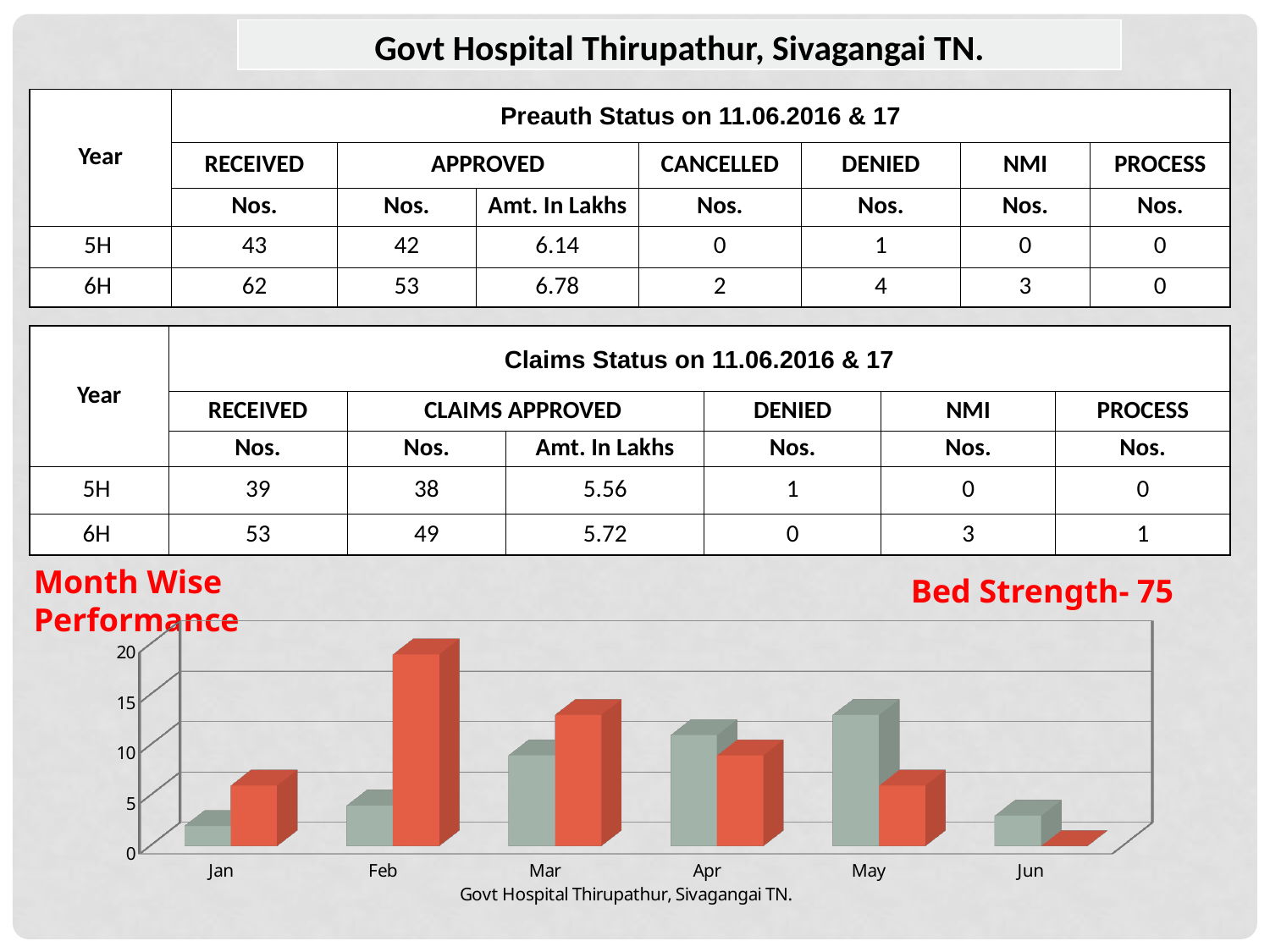
In the Month Wise Performance chart, is the red bar for Feb greater or less than 15? greater What text appears below the x axis of the Month Wise Performance chart? Govt Hospital Thirupathur, Sivagangai TN. In the Month Wise Performance chart, is the red bar for Jun greater or less than 5? less How many series of bars are plotted for each month in the Month Wise Performance chart? 2 In the Month Wise Performance chart, which bar is taller for Feb, the grey bar or the red bar? the red bar What kind of chart is shown under the heading 'Month Wise Performance'? bar chart In the Month Wise Performance chart, is the red bar for Mar greater or less than 10? greater How many months are shown on the x axis of the Month Wise Performance chart? 6 In the Month Wise Performance chart, which month has the shortest red bar? Jun In the Month Wise Performance chart, which month has the tallest red bar? Feb In the Month Wise Performance chart, which month has the tallest grey bar? May